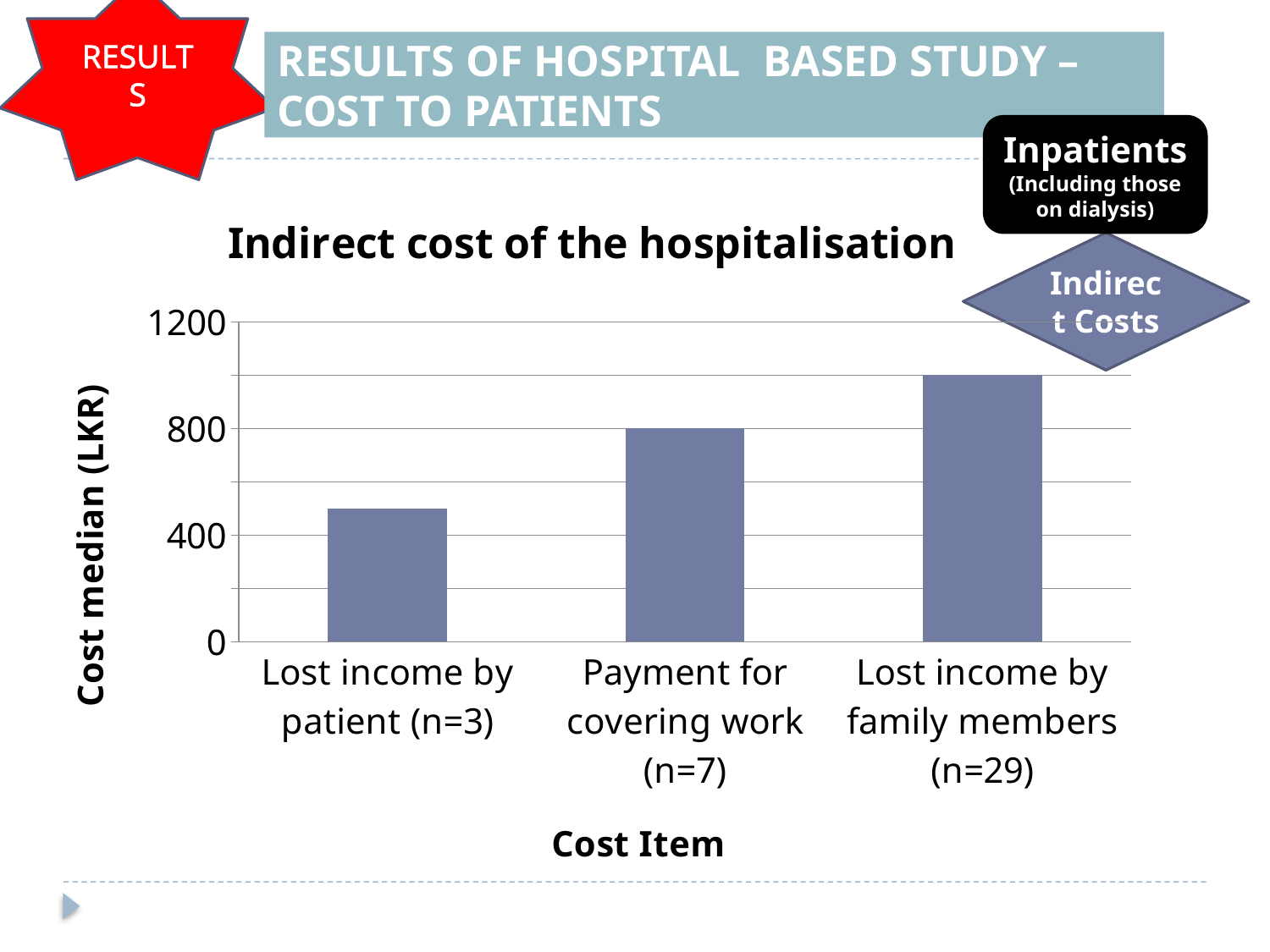
Which is larger: the median cost for Payment for covering work (n=7) or for Lost income by patient (n=3)? Payment for covering work (n=7) Is the value for Lost income by patient (n=3) greater or less than 400? greater Is the value for Lost income by family members (n=29) greater or less than 800? greater What is the label on the vertical axis of the chart? Cost median (LKR) Do the bar values rise or fall from left to right along the x axis? Rise Is the value for Lost income by patient (n=3) greater or less than 800? less What is the median cost for Payment for covering work (n=7)? 800 Which cost item has the highest median cost? Lost income by family members (n=29) What kind of chart is shown on the slide? Bar chart What is the title of the chart? Indirect cost of the hospitalisation Which cost item has the lowest median cost? Lost income by patient (n=3) How many cost items are plotted in the chart? 3